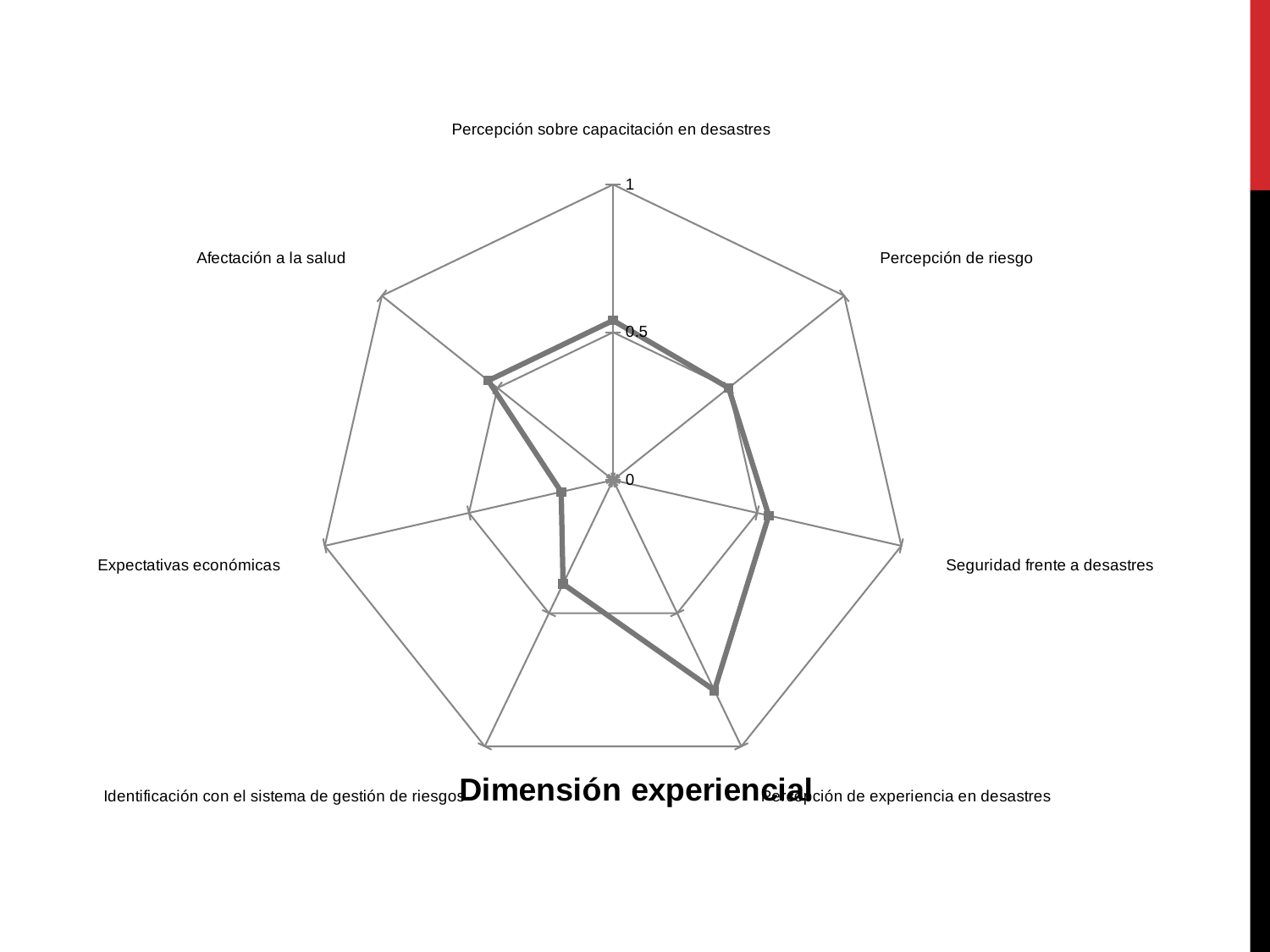
Which category has the lowest value in the chart? Expectativas económicas Is the value for Percepción de experiencia en desastres greater or less than 0.5? greater Which category has the highest value in the chart? Percepción de experiencia en desastres Is the value for Expectativas económicas greater or less than 0.5? less What kind of chart is shown on the slide? Radar chart Which is larger: the value for Percepción de experiencia en desastres or the value for Expectativas económicas? Percepción de experiencia en desastres Which is larger: the value for Afectación a la salud or the value for Expectativas económicas? Afectación a la salud Is the value for Identificación con el sistema de gestión de riesgos greater or less than 0.5? less What is the title of the chart? Dimensión experiencial How many categories (axes) does the radar chart have? 7 What is the maximum value shown on the chart's radial axis? 1